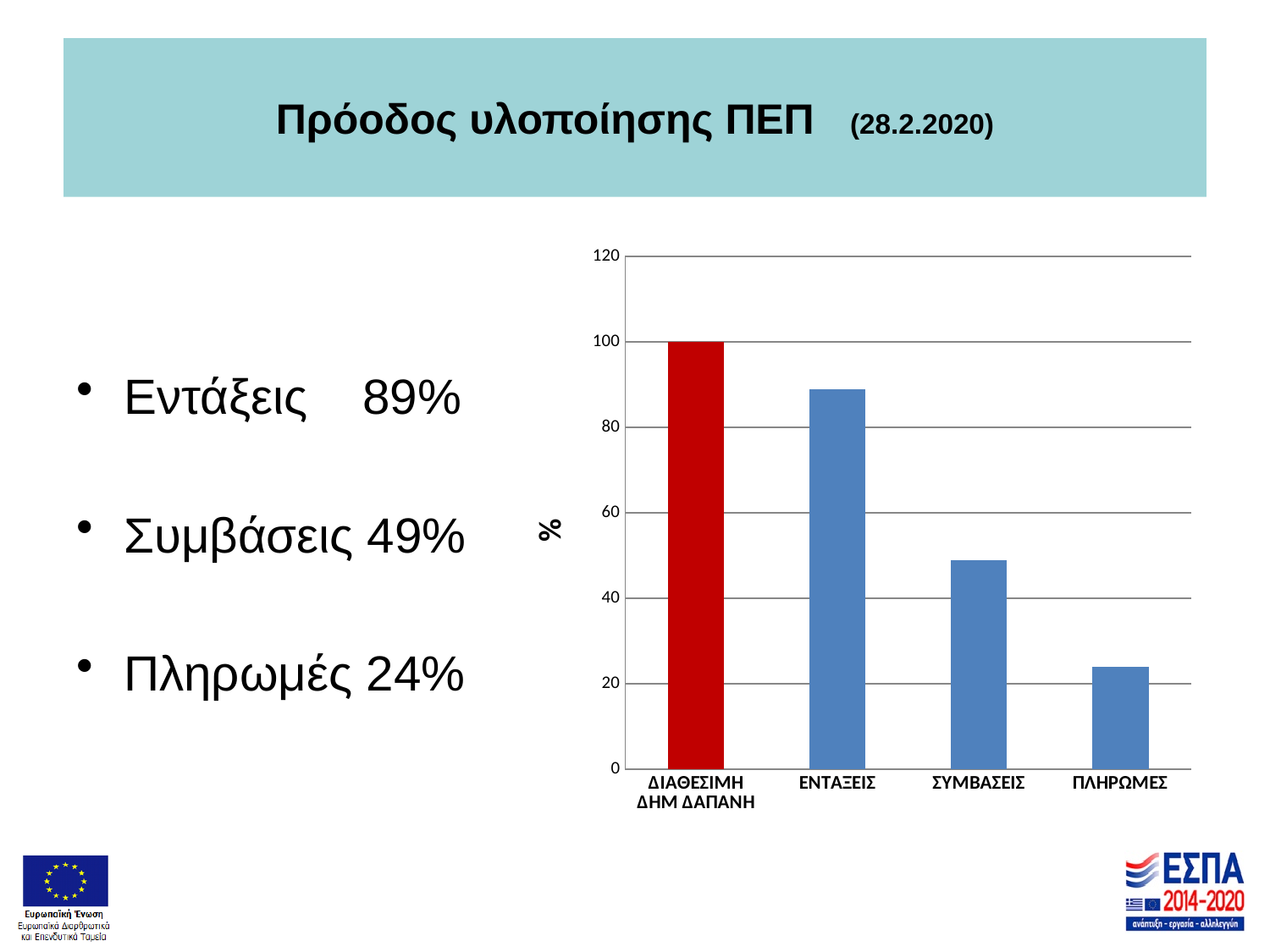
Which is larger, the bar for ΕΝΤΑΞΕΙΣ or the bar for ΣΥΜΒΑΣΕΙΣ? ΕΝΤΑΞΕΙΣ According to the slide, what is the value for Εντάξεις (ΕΝΤΑΞΕΙΣ)? 89% According to the slide, what is the value for Πληρωμές (ΠΛΗΡΩΜΕΣ)? 24% How many categories are shown on the x axis of the chart? 4 Which category has the highest bar in the chart? ΔΙΑΘΕΣΙΜΗ ΔΗΜ ΔΑΠΑΝΗ Which category has the lowest bar in the chart? ΠΛΗΡΩΜΕΣ What is the value of the bar for ΔΙΑΘΕΣΙΜΗ ΔΗΜ ΔΑΠΑΝΗ? 100 Is the value for ΕΝΤΑΞΕΙΣ greater or less than 80? greater Do the bar values rise or fall from left to right along the x axis? fall What colour is the bar for ΔΙΑΘΕΣΙΜΗ ΔΗΜ ΔΑΠΑΝΗ? red Is the value for ΣΥΜΒΑΣΕΙΣ greater or less than 60? less What type of chart is shown on the slide? bar chart